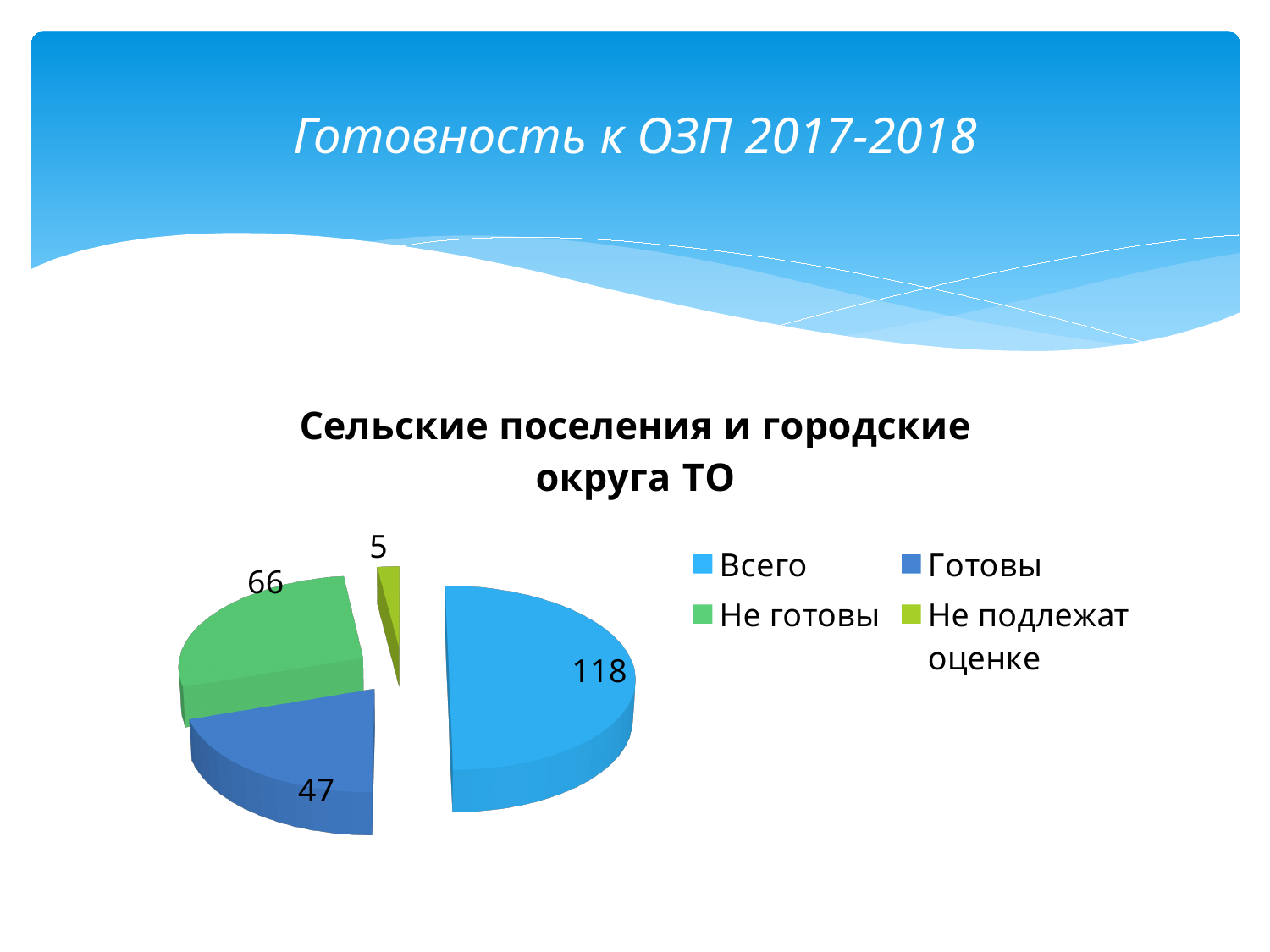
What is the title of the chart on the slide? Сельские поселения и городские округа ТО What kind of chart is shown on the slide? Pie chart Which category has the largest slice in the pie chart? Всего What is the value for Всего in the pie chart? 118 How many categories does the pie chart show? 4 Which is larger, the value for Готовы or the value for Не готовы? Не готовы What is the value for Не готовы in the pie chart? 66 What is the value for Не подлежат оценке in the pie chart? 5 What is the value for Готовы in the pie chart? 47 What is the difference between the values for Всего and Не готовы? 52 What is the difference between the values for Не готовы and Готовы? 19 Which category has the smallest slice in the pie chart? Не подлежат оценке